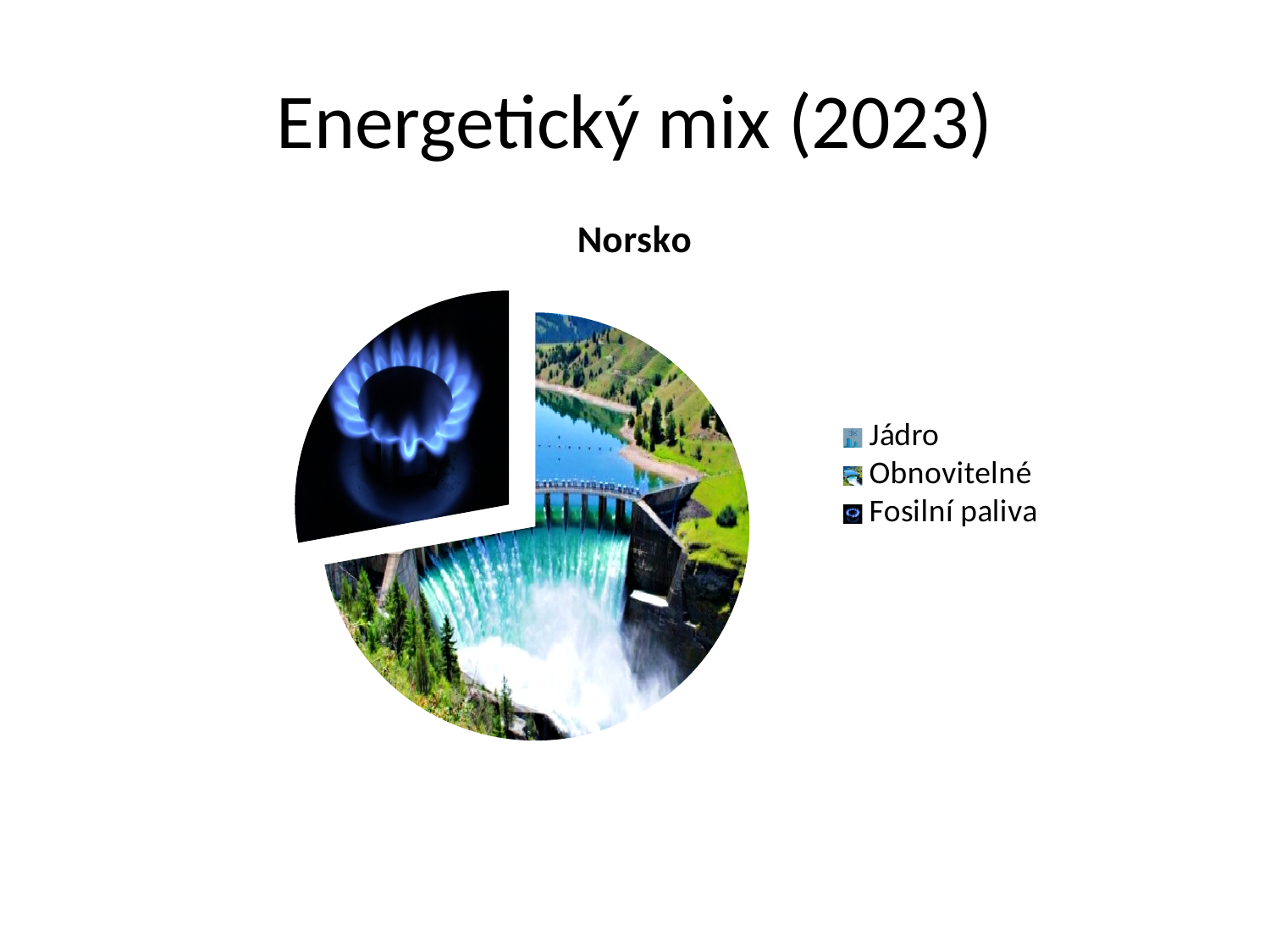
Which slice is larger in the pie chart, Obnovitelné or Fosilní paliva? Obnovitelné What kind of chart is shown on the slide? pie chart How many entries does the legend of the pie chart list? 3 Which slice is smaller in the pie chart, Fosilní paliva or Obnovitelné? Fosilní paliva Which legend entry is listed first in the pie chart's legend? Jádro What is the title of the pie chart? Norsko Does the Obnovitelné slice take up more or less than half of the pie? more Which category has the largest slice in the pie chart? Obnovitelné